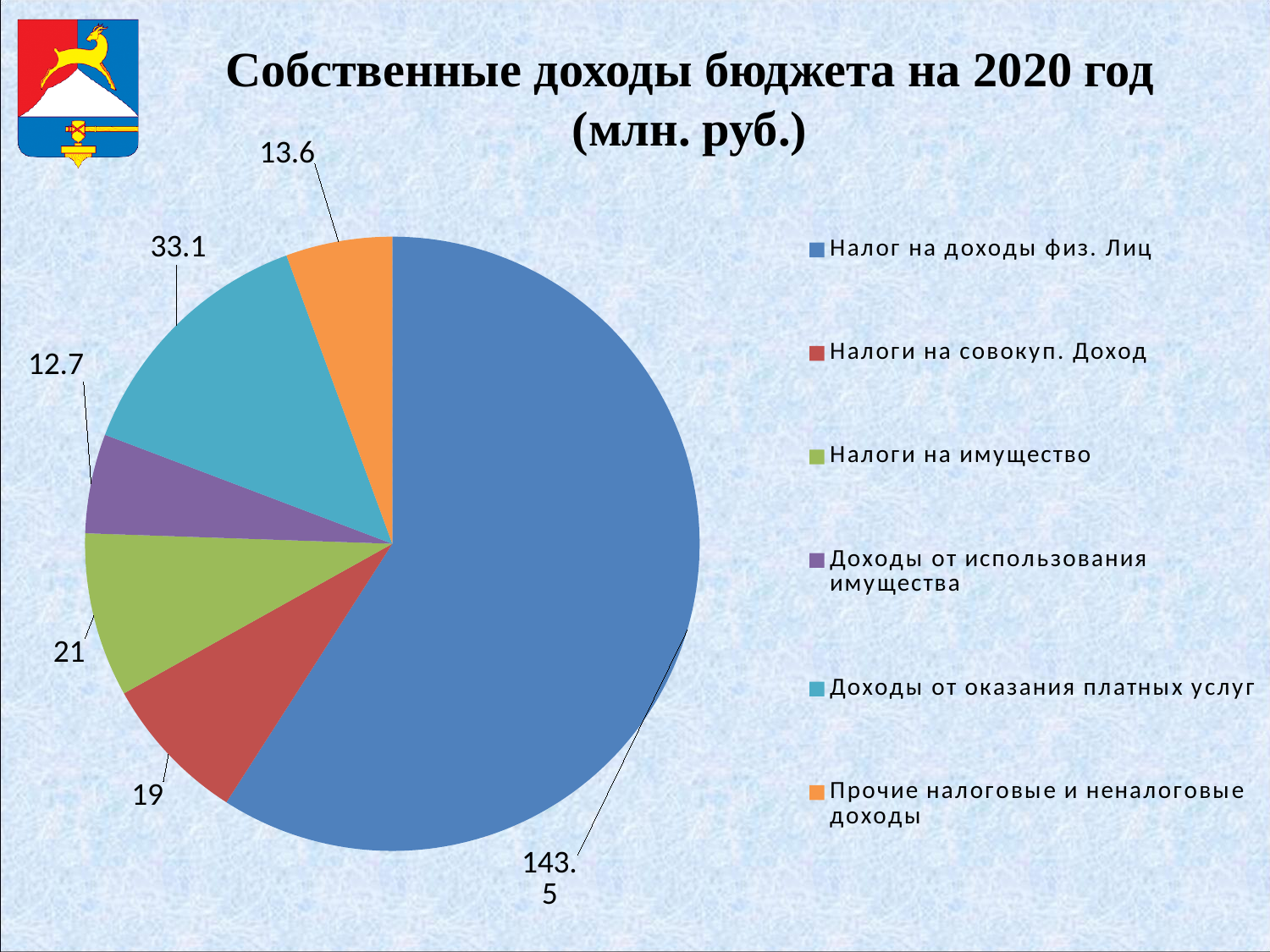
What is the difference between Налоги на имущество and Налоги на совокуп. Доход? 2 What is the difference between Доходы от оказания платных услуг and Прочие налоговые и неналоговые доходы? 19.5 How many categories does the pie chart show? 6 What is the value for Доходы от оказания платных услуг? 33.1 What is the value for Доходы от использования имущества? 12.7 Which is larger, Налоги на имущество or Налоги на совокуп. Доход? Налоги на имущество What is the value for Налог на доходы физ. Лиц? 143.5 Which category has the largest slice of the pie? Налог на доходы физ. Лиц Which category has the smallest slice of the pie? Доходы от использования имущества What is the value for Прочие налоговые и неналоговые доходы? 13.6 What is the title of the chart? Собственные доходы бюджета на 2020 год (млн. руб.) What kind of chart is shown on the slide? Pie chart